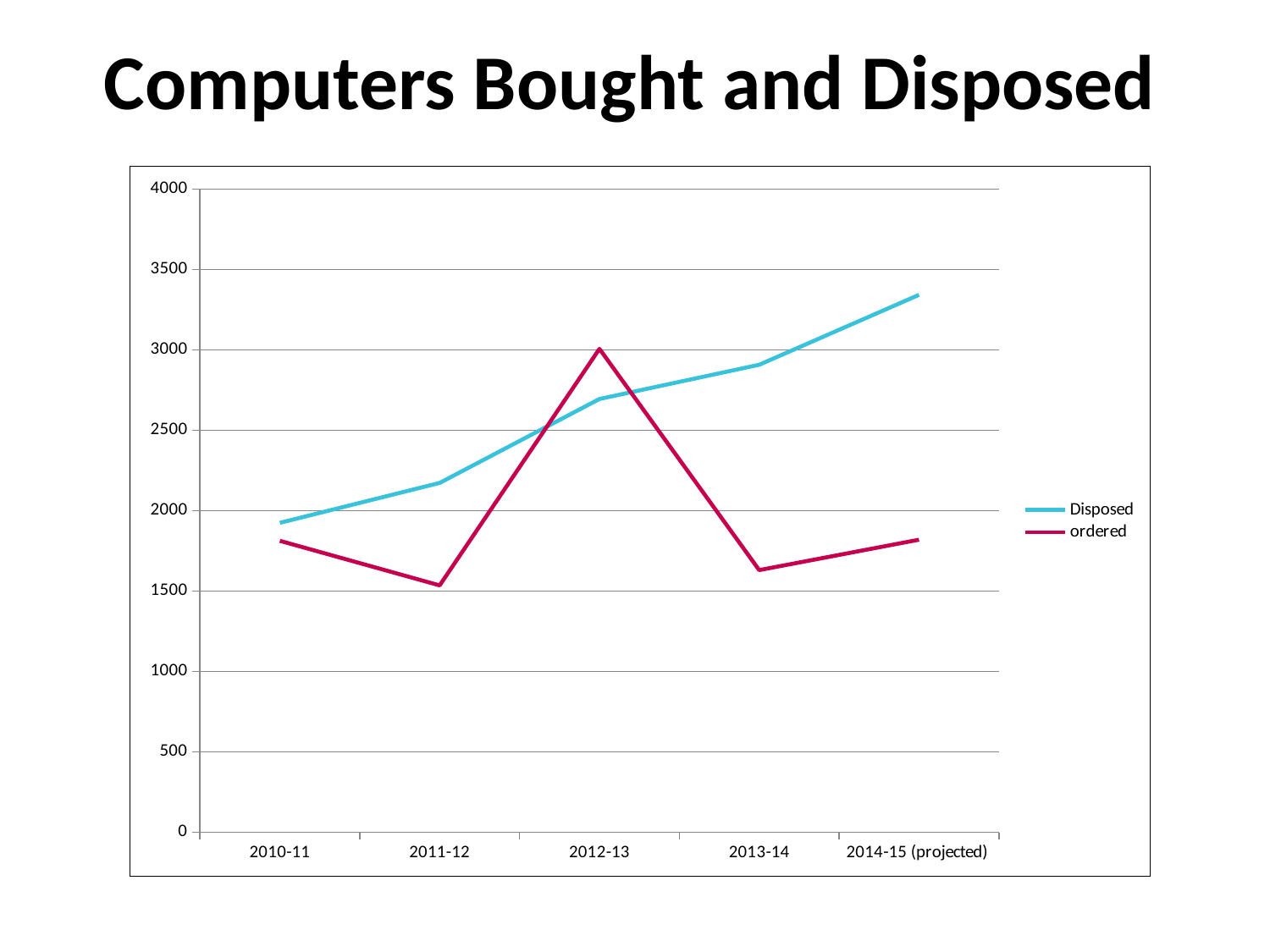
Is the Disposed value for 2014-15 (projected) greater or less than 3000? greater In which year is the ordered series highest? 2012-13 Is the ordered value for 2011-12 greater or less than 2000? less How many series does the legend list? 2 In which year is the Disposed series highest? 2014-15 (projected) Does the Disposed series rise or fall from 2010-11 to 2014-15 (projected)? rise What is the title of the chart? Computers Bought and Disposed In which year is the Disposed series lowest? 2010-11 In 2012-13, which series has the larger value, Disposed or ordered? ordered How many year categories are shown on the x axis? 5 What kind of chart is shown on the slide? line chart In 2013-14, which series has the larger value, Disposed or ordered? Disposed